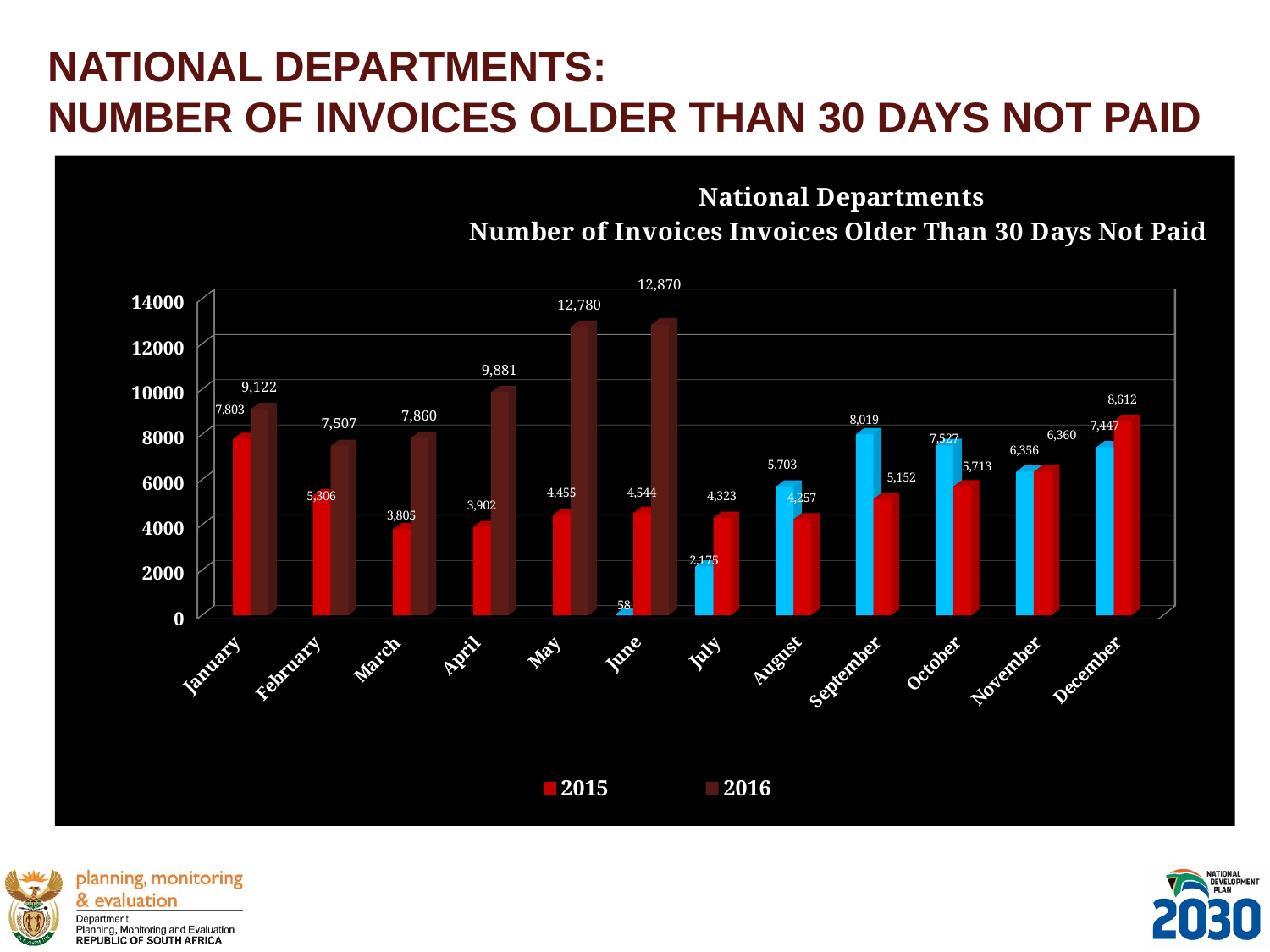
What is the value for 2016 in May? 12,780 In which month is the 2015 value lowest? March Which is larger in February, the 2015 value or the 2016 value? 2016 In which month is the 2015 value highest? December What is the value for 2015 in March? 3,805 What kind of chart is shown on the slide? Bar chart Is the 2015 value for December greater or less than 8000? greater In which month is the 2016 value highest? June What is the difference between the 2016 and 2015 values in May? 8,325 What is the difference between the 2016 and 2015 values in January? 1,319 What is the value for 2016 in January? 9,122 How many series does the legend list? 2